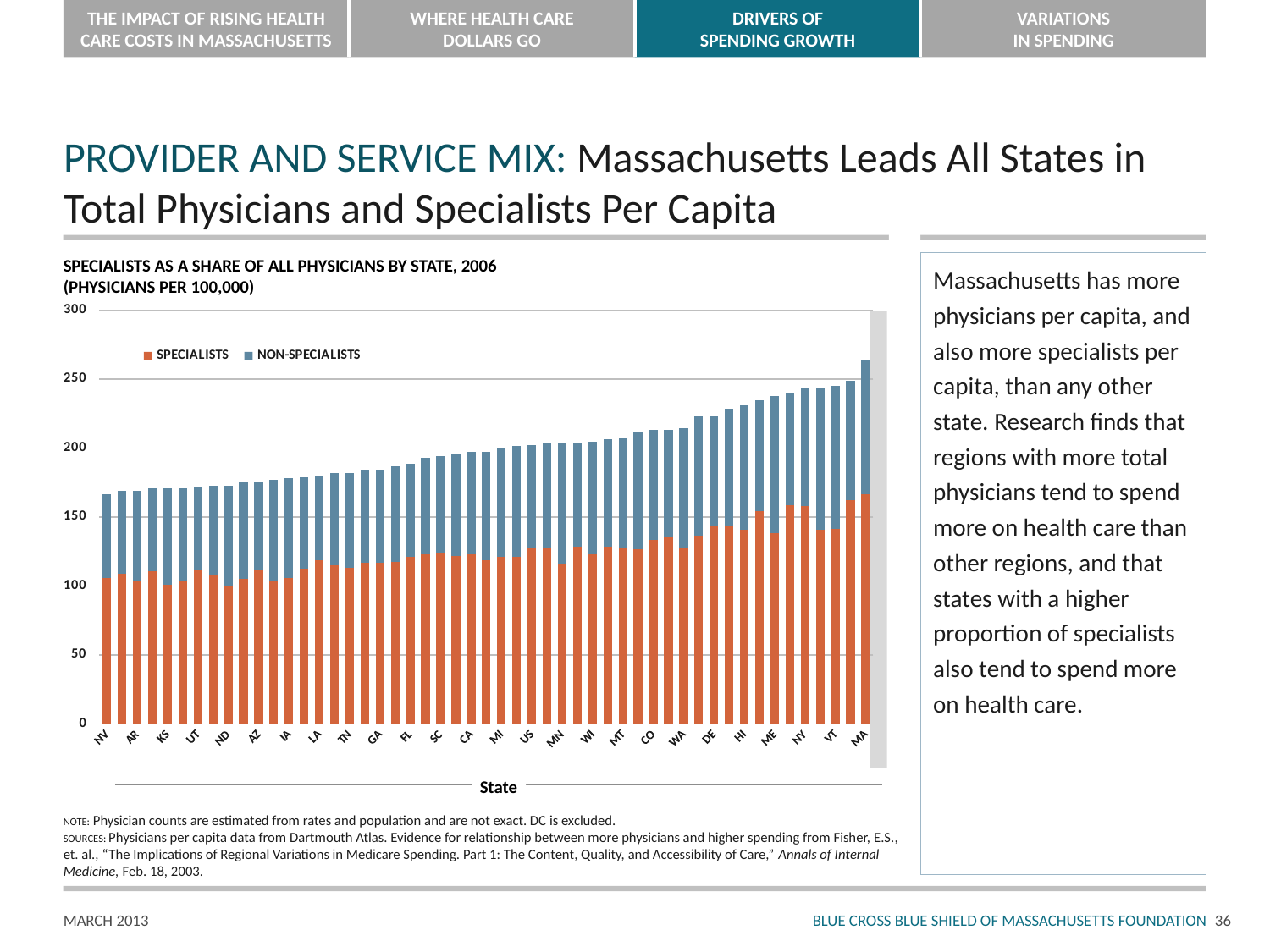
Is the total value for GA greater or less than 200? less Which has a larger total value, MA or NV? MA Which state has the highest total physicians per 100,000 in the chart? MA Is the Specialists value for MA greater or less than 150? greater Is the total value for NV greater or less than 150? greater Do the total bar heights rise or fall moving from left to right along the x axis? Rise Which colour represents Specialists in the chart? Orange How many series does the chart legend list? 2 What kind of chart is shown on the slide? Stacked bar chart